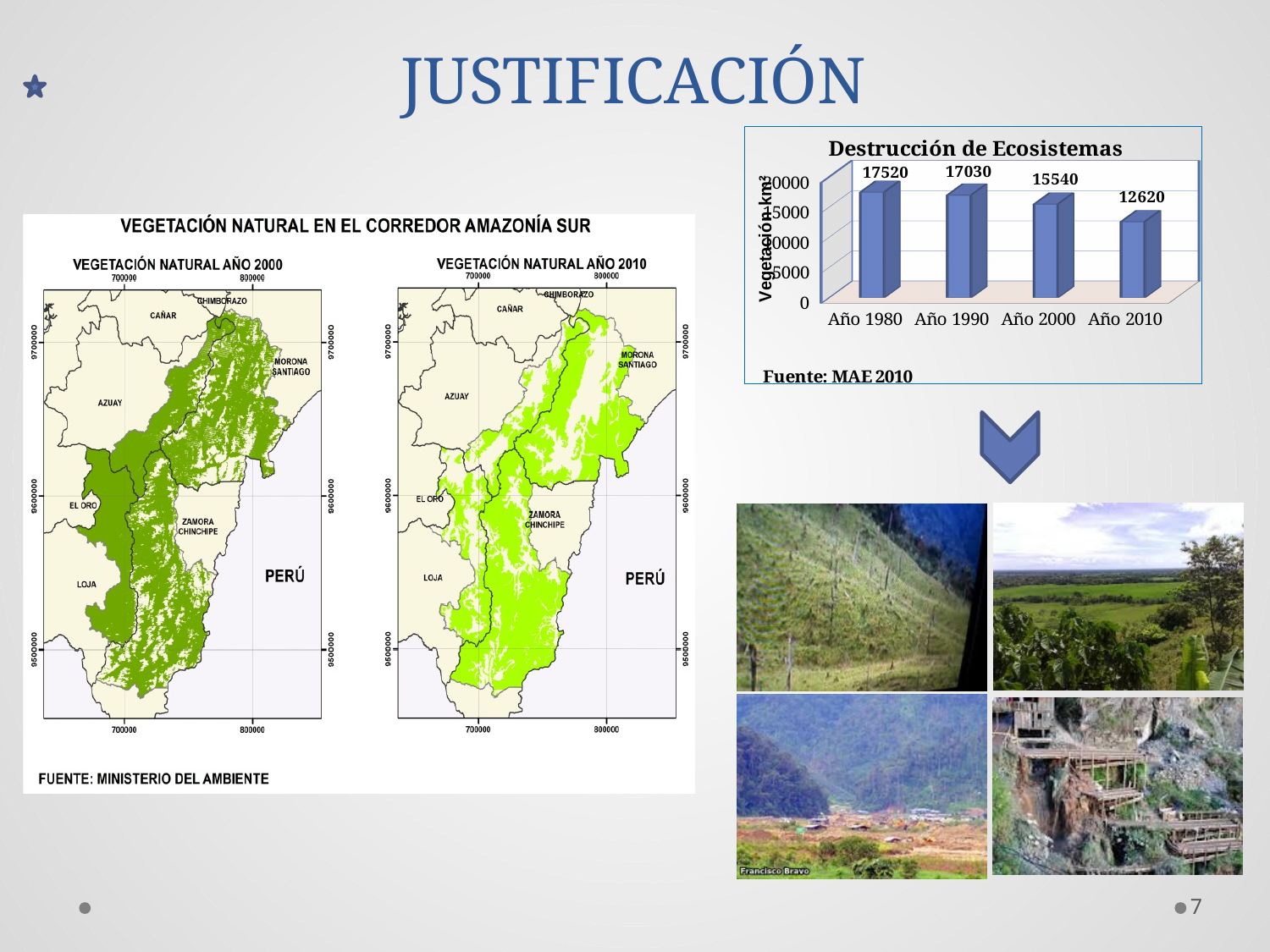
What is the value for Año 2000 in the Destrucción de Ecosistemas chart? 15540 What is the value for Año 2010 in the Destrucción de Ecosistemas chart? 12620 How many years are shown in the Destrucción de Ecosistemas chart? 4 What kind of chart is the Destrucción de Ecosistemas chart? bar chart What is the value for Año 1980 in the Destrucción de Ecosistemas chart? 17520 Is the value for Año 2010 in the Destrucción de Ecosistemas chart greater or less than 15000? less Which year has the highest value in the Destrucción de Ecosistemas chart? Año 1980 What is the difference between the values for Año 1980 and Año 2010 in the Destrucción de Ecosistemas chart? 4900 What is the difference between the values for Año 1990 and Año 2000 in the Destrucción de Ecosistemas chart? 1490 Which is larger in the Destrucción de Ecosistemas chart, the value for Año 1990 or Año 2000? Año 1990 Do the values in the Destrucción de Ecosistemas chart rise or fall from Año 1980 to Año 2010? fall Which year has the lowest value in the Destrucción de Ecosistemas chart? Año 2010